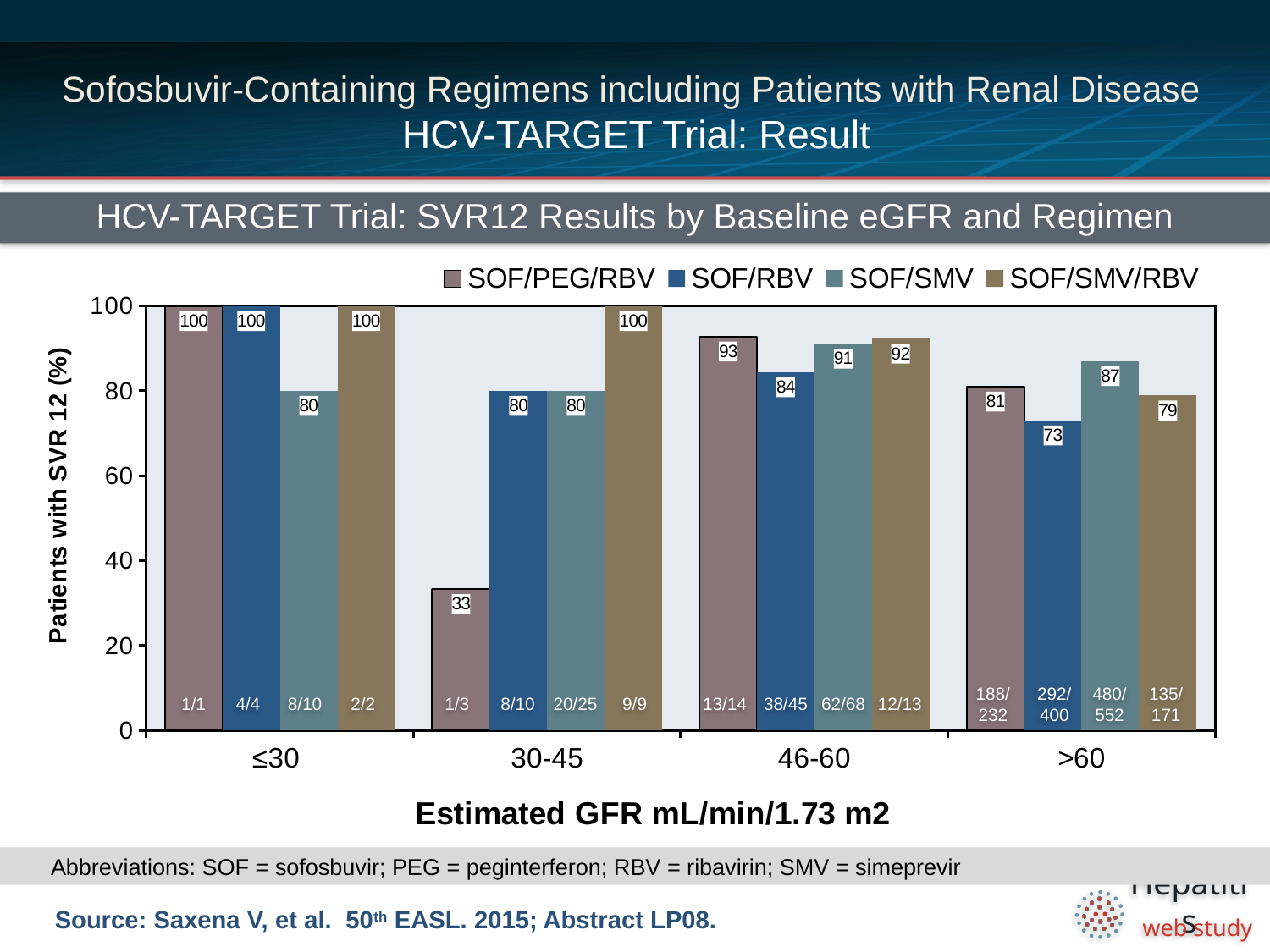
Which regimen has the lowest SVR12 rate in the 30-45 eGFR group? SOF/PEG/RBV What is the difference between the SVR12 rates for SOF/SMV and SOF/RBV in the >60 eGFR group? 14 In the 46-60 eGFR group, which has a higher SVR12 rate: SOF/PEG/RBV or SOF/RBV? SOF/PEG/RBV What type of chart is shown on the slide? Bar chart What is the SVR12 rate for SOF/RBV in the >60 eGFR group? 73 How many eGFR categories are shown on the x axis? 4 What is the SVR12 rate for SOF/SMV in the 46-60 eGFR group? 91 How many regimens does the legend list? 4 Which regimen has the highest SVR12 rate in the >60 eGFR group? SOF/SMV What is the SVR12 rate for SOF/PEG/RBV in the 30-45 eGFR group? 33 What is the label of the y axis? Patients with SVR 12 (%) What is the SVR12 rate for SOF/SMV/RBV in the 46-60 eGFR group? 92